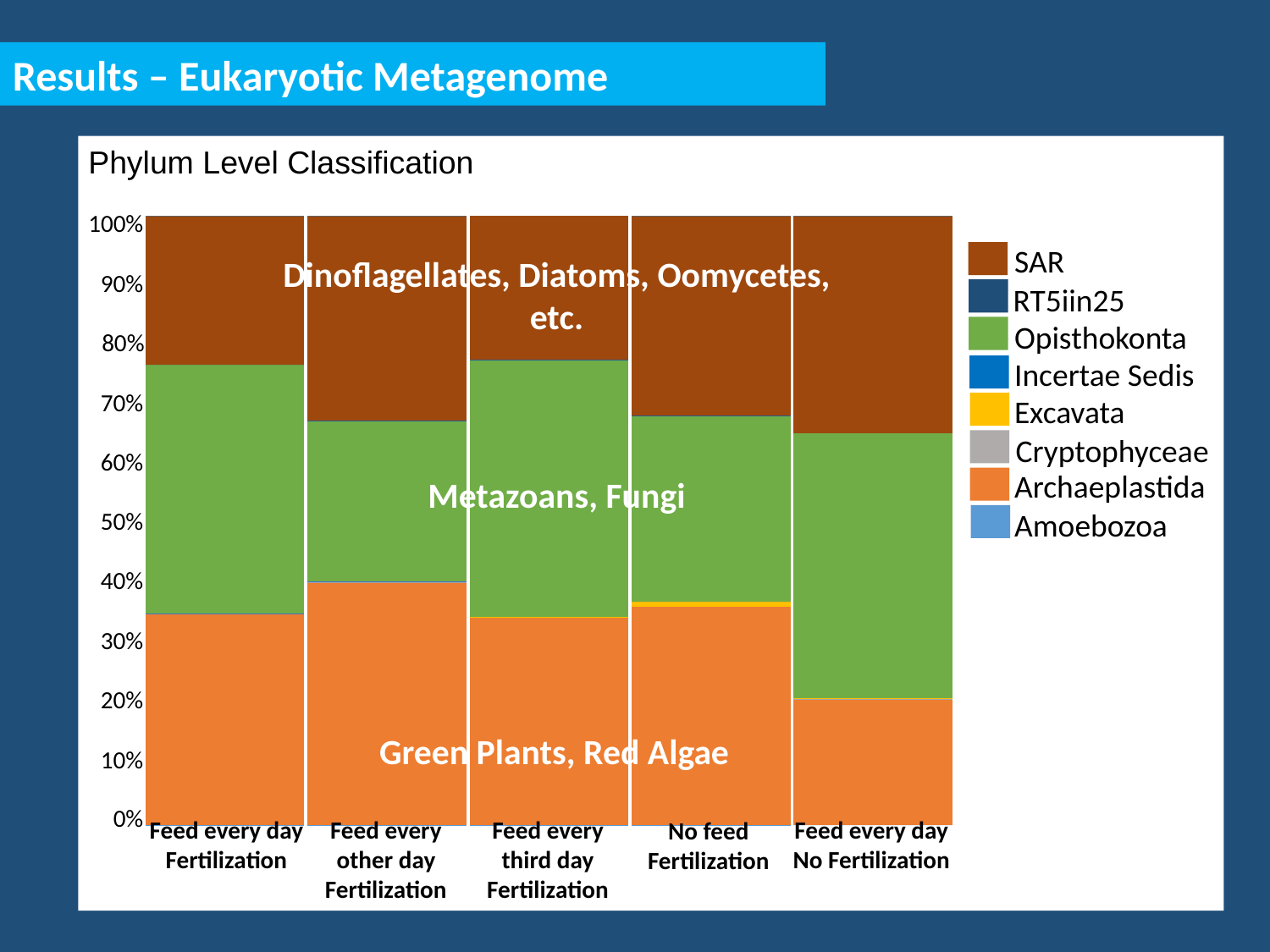
What kind of chart is shown on the slide? Stacked bar chart Is the Archaeplastida share for Feed every day Fertilization greater or less than 40%? less What is the title of the chart? Phylum Level Classification Is the Archaeplastida share for Feed every other day Fertilization greater or less than 30%? greater Which category has the lowest Archaeplastida share? Feed every day No Fertilization Which has the larger Archaeplastida share: Feed every day Fertilization or Feed every day No Fertilization? Feed every day Fertilization How many series does the chart's legend list? 8 Which has the larger Archaeplastida share: Feed every other day Fertilization or Feed every day No Fertilization? Feed every other day Fertilization How many categories are shown along the x axis of the chart? 5 Which legend entry is annotated on the chart as "Green Plants, Red Algae"? Archaeplastida Which category shows a visible Excavata segment? No feed Fertilization Is the Archaeplastida share for Feed every day No Fertilization greater or less than 30%? less